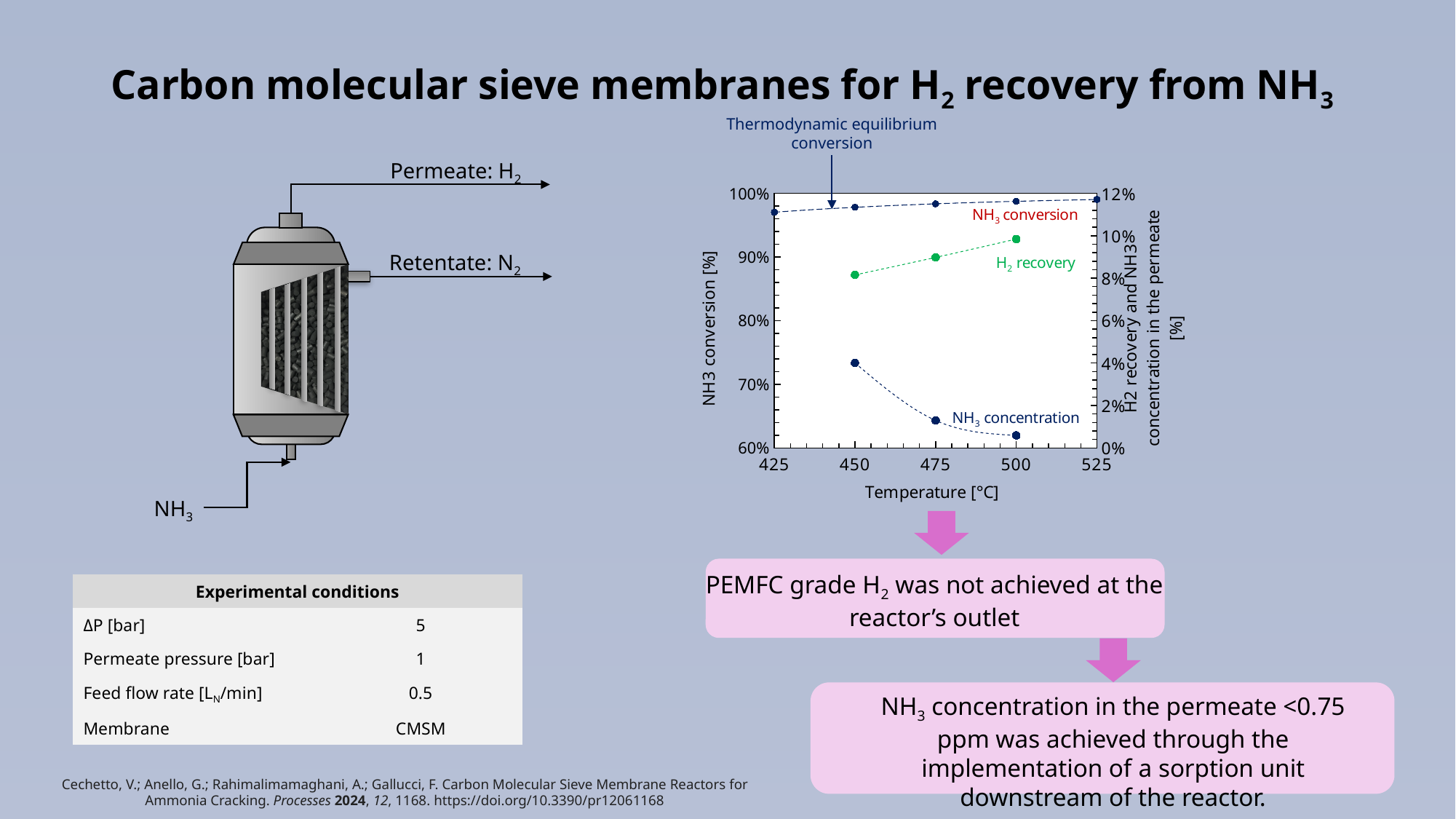
At which temperature is the NH3 concentration in the permeate highest? 450 °C Is the H2 recovery at 500 °C greater or less than 8%? greater What kind of chart is shown on the slide? line chart Which is larger at 475 °C: H2 recovery or NH3 concentration? H2 recovery How many data points are plotted for the H2 recovery series? 3 What is the left y-axis label of the chart? NH3 conversion [%] Is the NH3 concentration at 500 °C greater or less than 2%? less How many data points are plotted for the NH3 concentration series? 3 Is the NH3 conversion at 450 °C greater or less than 90%? greater What is the x-axis label of the chart? Temperature [°C] Does NH3 concentration in the permeate rise or fall as temperature increases from 450 to 500 °C? fall Does H2 recovery rise or fall as temperature increases from 450 to 500 °C? rise